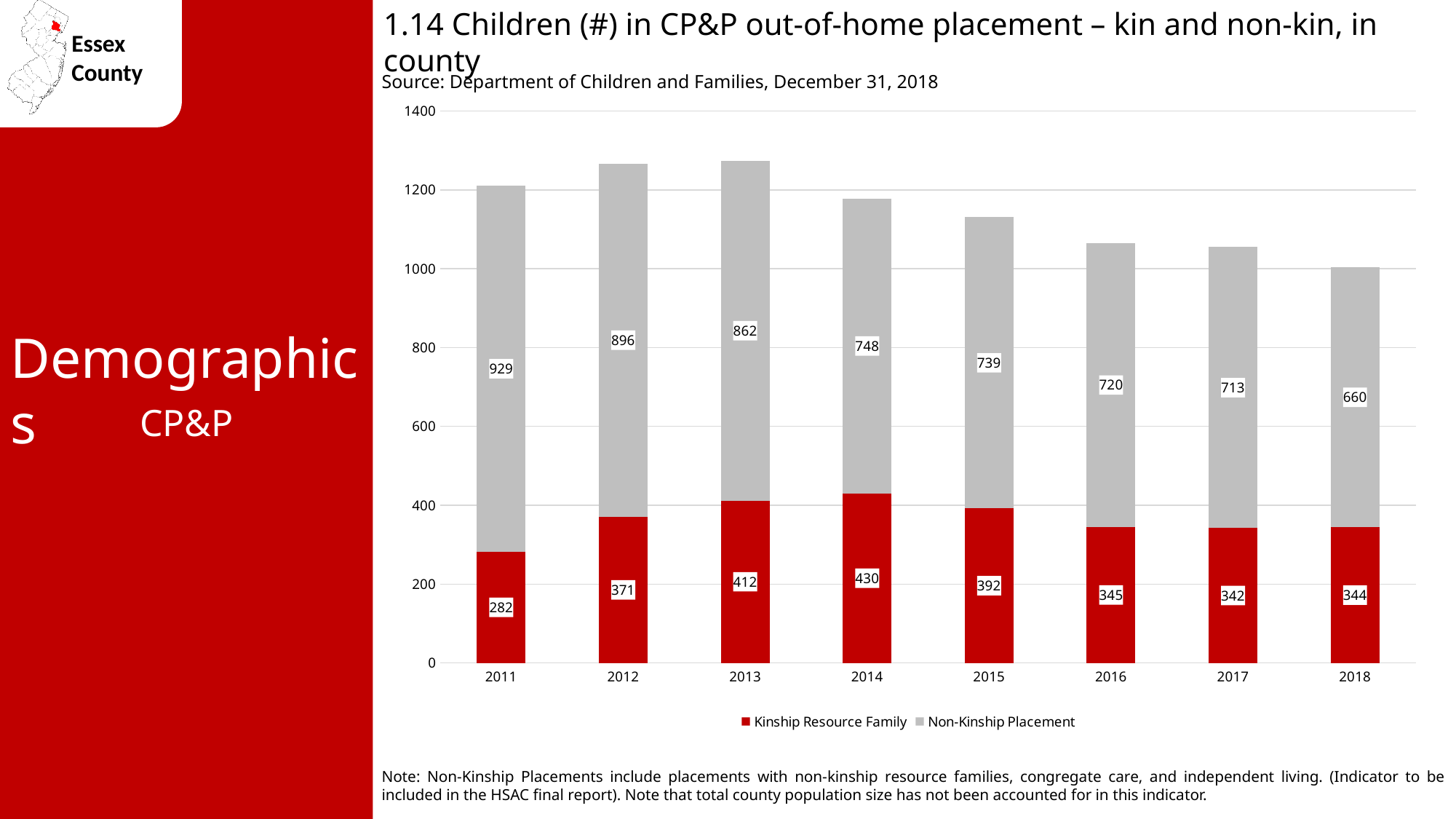
Which is larger, the Kinship Resource Family value for 2013 or for 2015? 2013 Do the Non-Kinship Placement values rise or fall from 2012 to 2018? Fall What is the difference between the Non-Kinship Placement values for 2011 and 2012? 33 Which year has the lowest Non-Kinship Placement value? 2018 What is the Kinship Resource Family value for 2014? 430 How many series does the legend list? 2 Which year has the lowest Kinship Resource Family value? 2011 What kind of chart is shown on the slide? Stacked bar chart What is the Non-Kinship Placement value for 2018? 660 What is the total of the stacked bar for 2013? 1274 How many years are shown on the x axis? 8 Which year has the highest Kinship Resource Family value? 2014